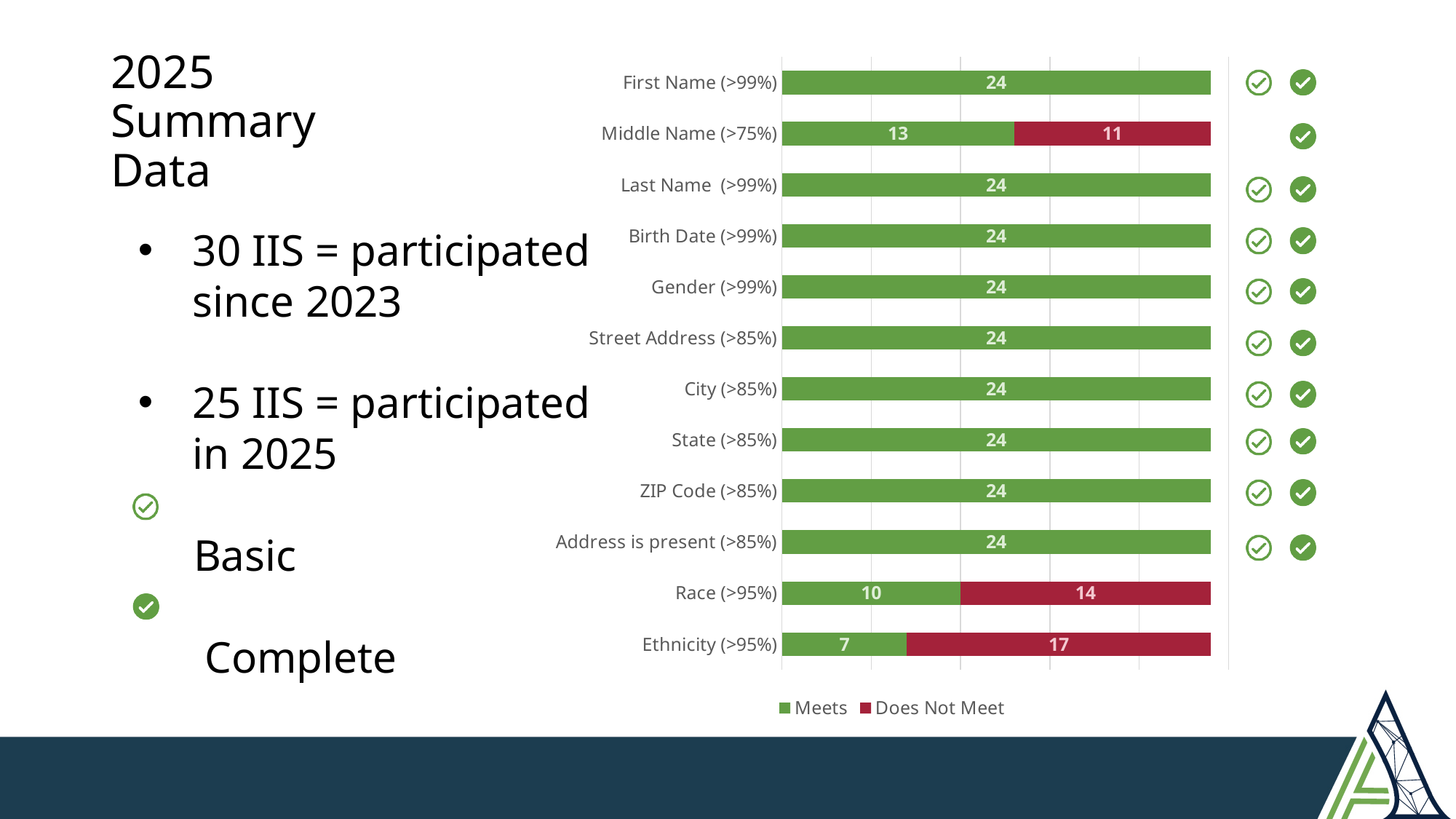
Which is larger: the "Meets" value for Middle Name (>75%) or the "Meets" value for Race (>95%)? Middle Name (>75%) Which category has the highest "Does Not Meet" value? Ethnicity (>95%) How many categories are shown on the chart? 12 What is the difference between the "Does Not Meet" values for Race (>95%) and Middle Name (>75%)? 3 What is the "Meets" value for Race (>95%)? 10 What kind of chart is shown on the slide? Stacked bar chart What is the "Does Not Meet" value for Ethnicity (>95%)? 17 What is the total of the stacked bar for Race (>95%)? 24 Which category has the lowest "Meets" value? Ethnicity (>95%) Which colour represents the "Does Not Meet" series? Red How many series does the legend list? 2 What is the "Meets" value for Middle Name (>75%)? 13